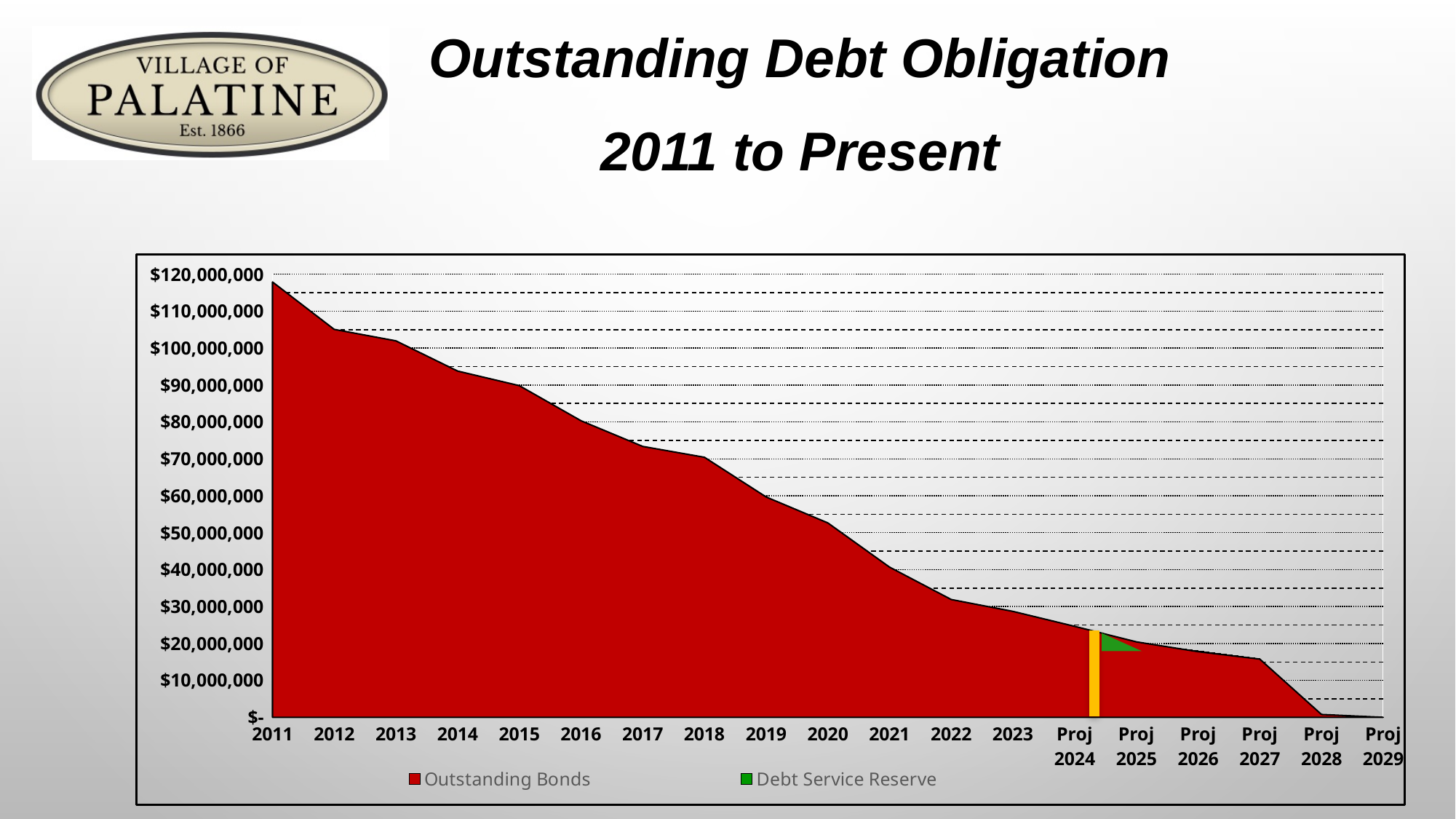
Is the value for Outstanding Bonds in 2011 greater or less than $110,000,000? greater Which year has the highest outstanding debt obligation? 2011 Which year has the lowest outstanding debt obligation? Proj 2029 Do the outstanding bond values rise or fall from 2011 to Proj 2029? Fall Is the value for Outstanding Bonds in Proj 2028 greater or less than $10,000,000? less What colour represents the Debt Service Reserve series in the legend? Green Is the value for Outstanding Bonds in 2017 greater or less than $70,000,000? greater How many years (categories) are shown along the x axis? 19 What kind of chart is shown on the slide? Area chart How many series does the legend list? 2 Which is larger, the outstanding bonds value for 2012 or for 2018? 2012